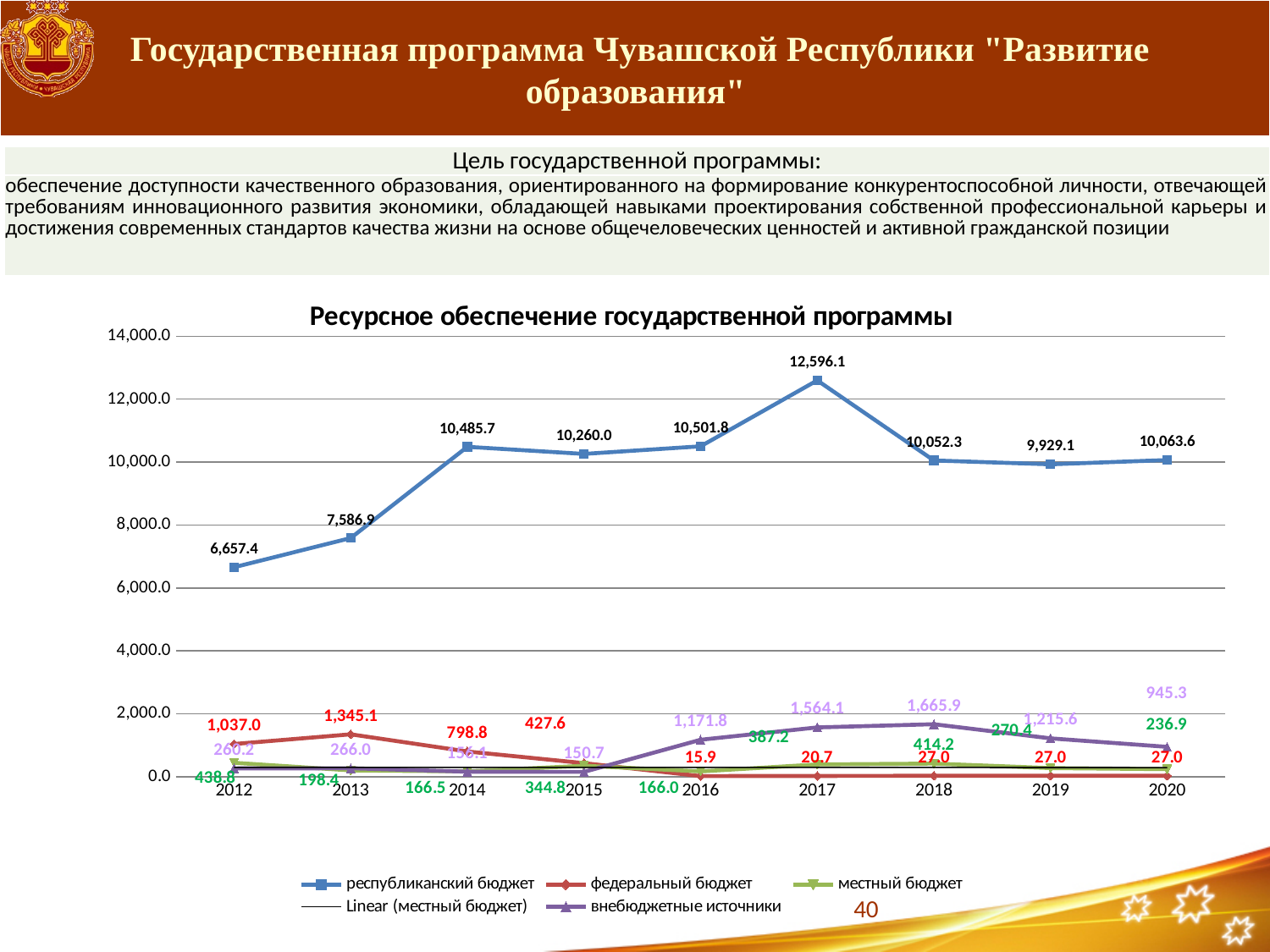
What is the value of республиканский бюджет in 2017? 12,596.1 What is the value of республиканский бюджет in 2012? 6,657.4 What is the value of внебюджетные источники in 2018? 1,665.9 How many series does the chart legend list? 5 Which is larger in 2020: внебюджетные источники or федеральный бюджет? внебюджетные источники What is the difference between республиканский бюджет in 2017 and in 2018? 2,543.8 What type of chart is shown on the slide? line chart How many years are plotted along the x axis? 9 In which year is республиканский бюджет highest? 2017 What is the value of федеральный бюджет in 2013? 1,345.1 In which year is республиканский бюджет lowest? 2012 What is the title of the chart? Ресурсное обеспечение государственной программы